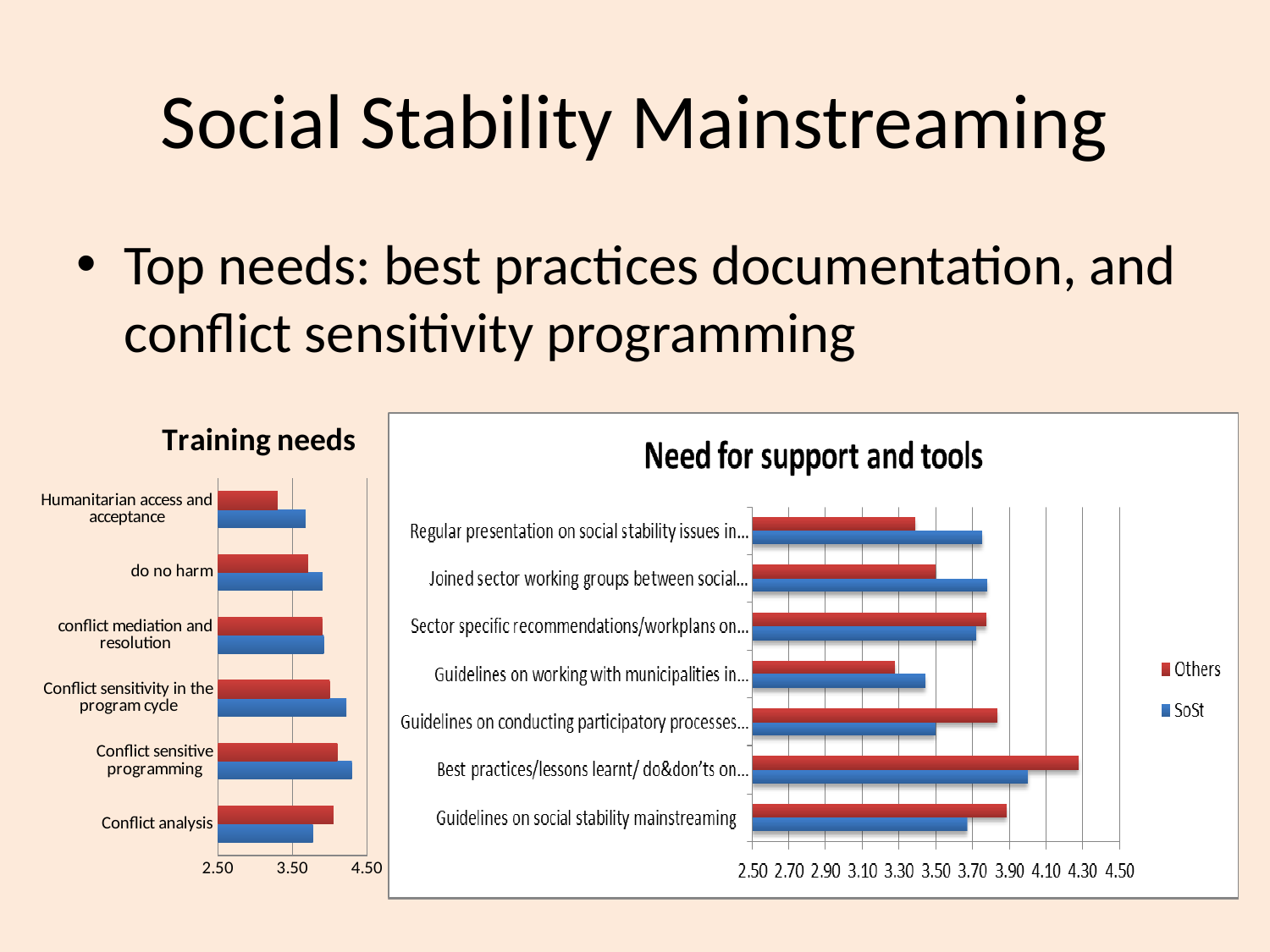
In the 'Training needs' chart, is the red bar for 'Humanitarian access and acceptance' greater or less than 3.50? less In the 'Need for support and tools' chart, which series has the larger value for 'Regular presentation on social stability issues in...', Others or SoSt? SoSt What kind of chart is the 'Training needs' chart? bar chart In the 'Need for support and tools' chart, is the 'Others' value for 'Best practices/lessons learnt/ do&don'ts on...' greater or less than 4.10? greater How many categories are shown in the 'Training needs' chart? 6 In the 'Training needs' chart, is the blue bar for 'Conflict sensitive programming' greater or less than 3.50? greater In the 'Need for support and tools' chart, which category has the lowest 'Others' value? Guidelines on working with municipalities in... In the 'Need for support and tools' chart, which category has the highest 'Others' value? Best practices/lessons learnt/ do&don'ts on... How many series does the legend of the 'Need for support and tools' chart list? 2 In the 'Training needs' chart, which category has the longest bar overall? Conflict sensitive programming How many categories are shown in the 'Need for support and tools' chart? 7 In the 'Need for support and tools' chart, which colour represents the 'Others' series? red